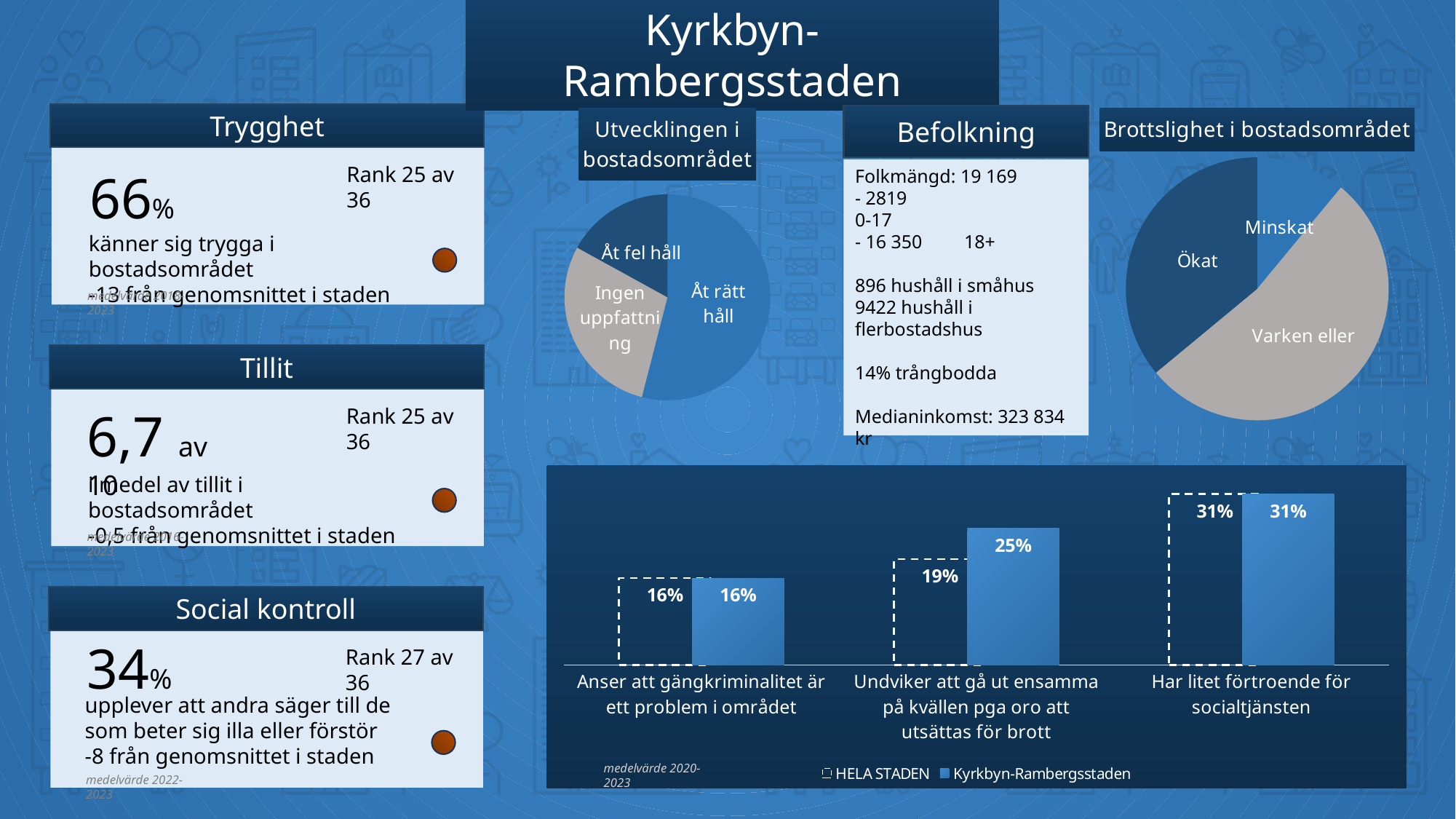
In the pie chart 'Brottslighet i bostadsområdet', which slice is the largest? Varken eller In the bar chart at the bottom of the slide, what is the value for HELA STADEN for 'Undviker att gå ut ensamma på kvällen pga oro att utsättas för brott'? 19% What kind of chart is 'Utvecklingen i bostadsområdet'? Pie chart In the bar chart at the bottom of the slide, which category has the highest value for Kyrkbyn-Rambergsstaden? Har litet förtroende för socialtjänsten In the bar chart at the bottom of the slide, how many series does the legend list? 2 In the bar chart at the bottom of the slide, what is the value for HELA STADEN for 'Anser att gängkriminalitet är ett problem i området'? 16% In the bar chart at the bottom of the slide, what is the value for Kyrkbyn-Rambergsstaden for 'Undviker att gå ut ensamma på kvällen pga oro att utsättas för brott'? 25% In the bar chart at the bottom of the slide, what is the difference between Kyrkbyn-Rambergsstaden and HELA STADEN for 'Undviker att gå ut ensamma på kvällen pga oro att utsättas för brott'? 6% In the bar chart at the bottom of the slide, how many categories are shown? 3 In the pie chart 'Utvecklingen i bostadsområdet', which slice is the smallest? Åt fel håll In the bar chart at the bottom of the slide, which category has the lowest value for HELA STADEN? Anser att gängkriminalitet är ett problem i området In the bar chart at the bottom of the slide, what is the value for Kyrkbyn-Rambergsstaden for 'Har litet förtroende för socialtjänsten'? 31%